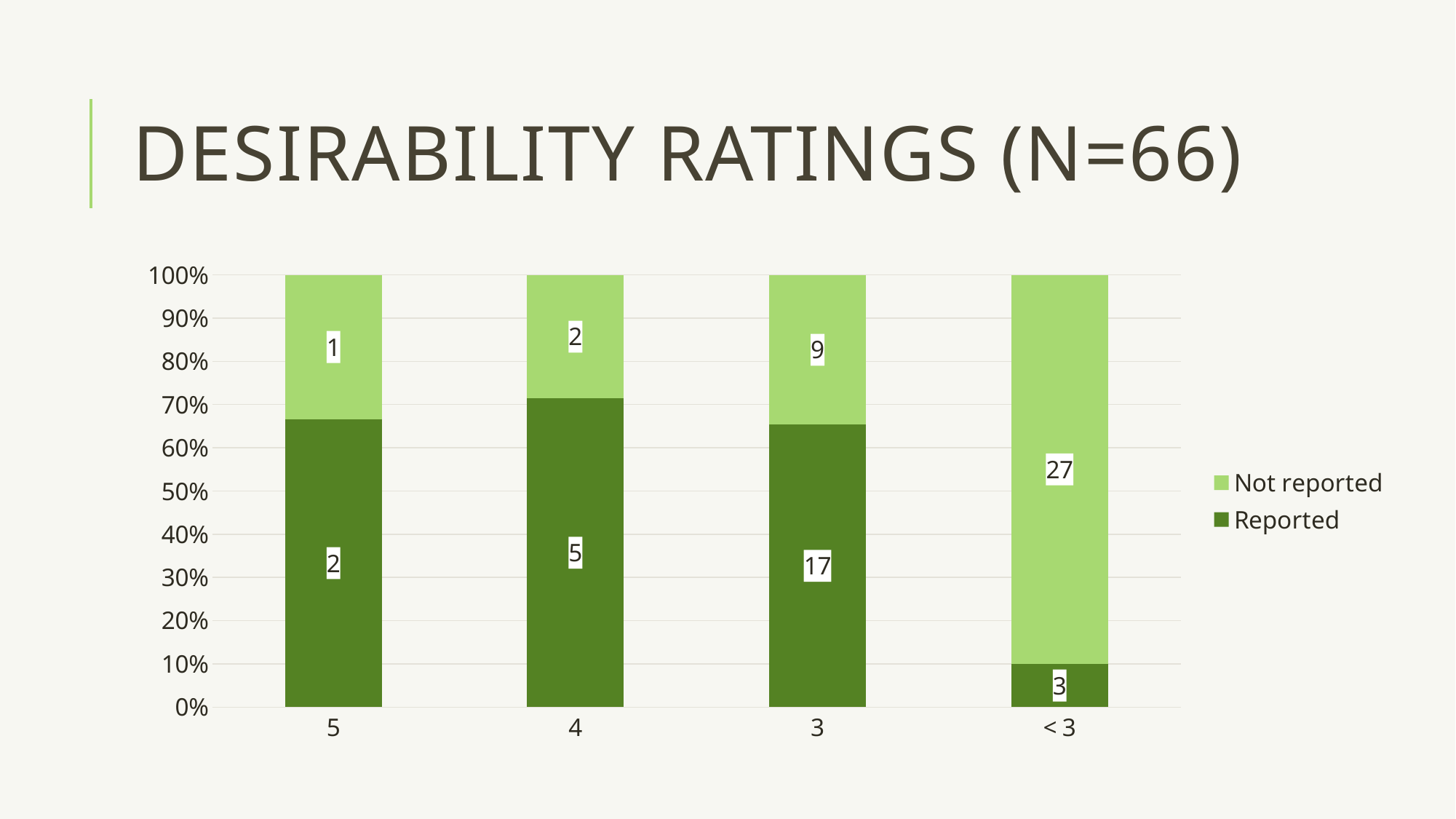
Which is larger: the Not reported count for rating 3 or the Not reported count for rating < 3? < 3 What is the total count (Reported plus Not reported) for rating < 3? 30 How many series does the legend list? 2 What is the Reported count for rating 5? 2 What is the difference between the Reported count for rating 3 and the Reported count for rating 4? 12 What is the Not reported count for rating < 3? 27 What is the Reported count for rating 3? 17 Which rating category has the lowest Not reported count? 5 What kind of chart is shown on the slide? Stacked bar chart How many rating categories are shown on the x axis? 4 What is the Not reported count for rating 4? 2 Which rating category has the highest Reported count? 3